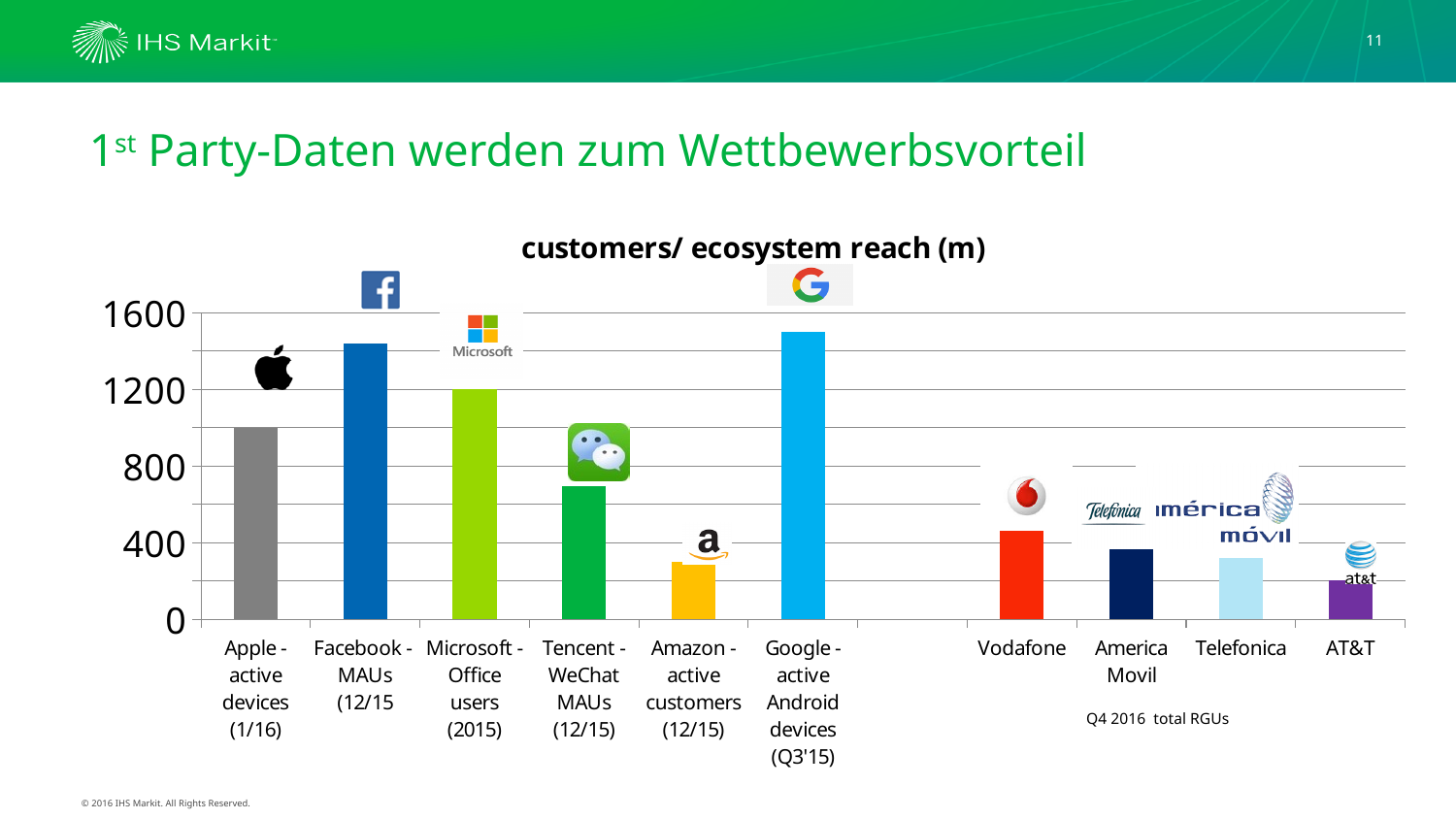
Is the value for Tencent - WeChat MAUs (12/15) greater or less than 800? less What is the title of the chart? customers/ ecosystem reach (m) How many categories (bars) are plotted in the chart? 10 Is the value for Amazon - active customers (12/15) greater or less than 400? less Which is larger, the value for Vodafone or the value for Telefonica? Vodafone Which is larger, the value for Facebook - MAUs or the value for Microsoft - Office users? Facebook - MAUs What note is printed below the telecom operator bars (Vodafone, America Movil, Telefonica, AT&T)? Q4 2016 total RGUs What kind of chart is shown on the slide? bar chart Which category has the lowest value in the chart? AT&T Is the value for Vodafone greater or less than 400? greater Which category has the highest value in the chart? Google - active Android devices (Q3'15)